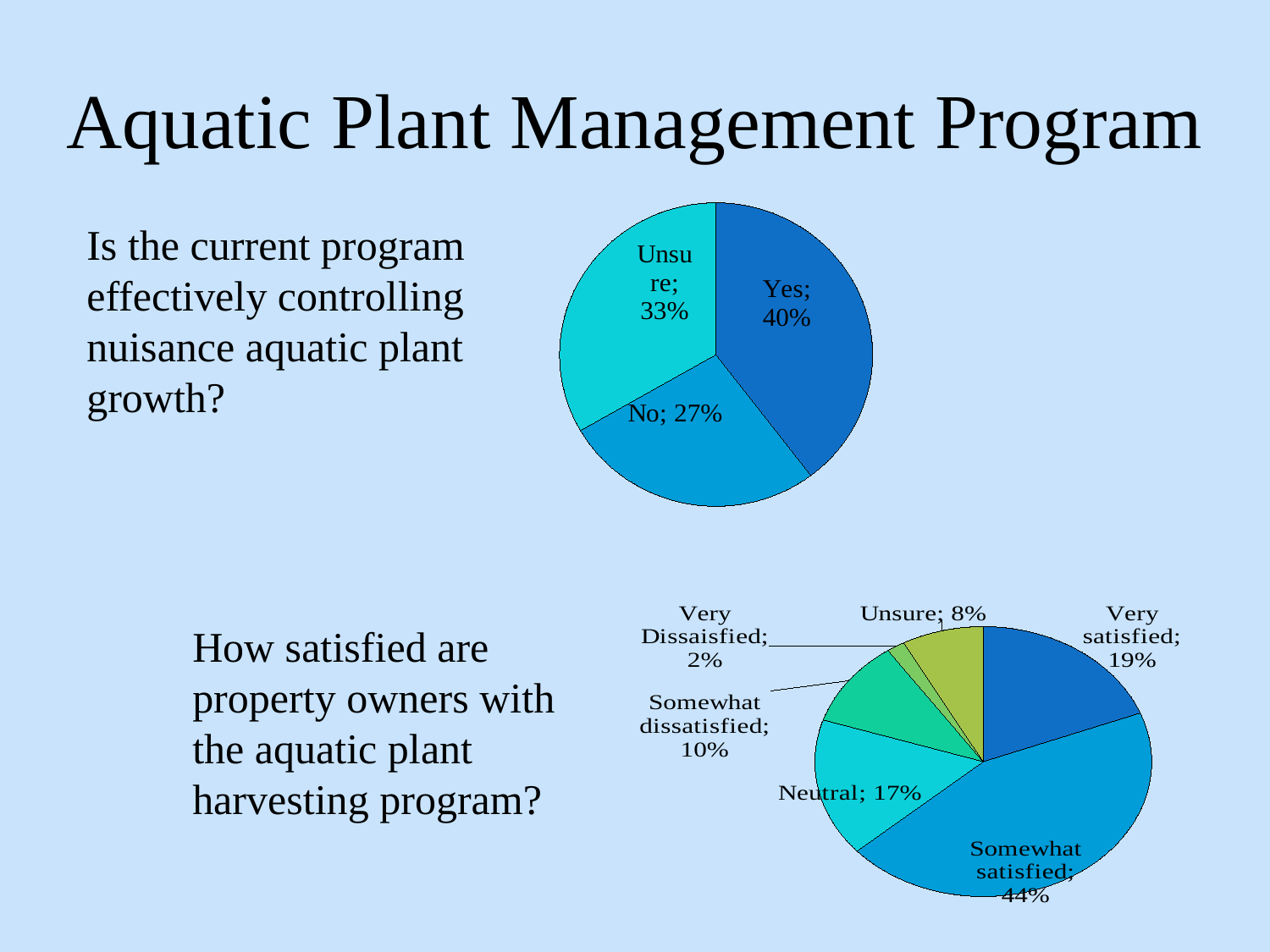
In the bottom pie chart, what percentage of property owners are Somewhat satisfied? 44% In the top pie chart, what percentage answered Yes? 40% How many slices does the top pie chart have? 3 In the bottom pie chart, what percentage are Neutral? 17% In the top pie chart, what is the difference between the Yes and No shares? 13% In the bottom pie chart, which category has the largest share? Somewhat satisfied In the top pie chart, what percentage answered Unsure? 33% In the bottom pie chart, which category has the smallest share? Very Dissaisfied What type of chart is the top chart on the slide? Pie chart In the bottom pie chart, which is larger: Very satisfied or Somewhat dissatisfied? Very satisfied How many slices does the bottom pie chart have? 6 In the top pie chart, which response has the smallest share? No